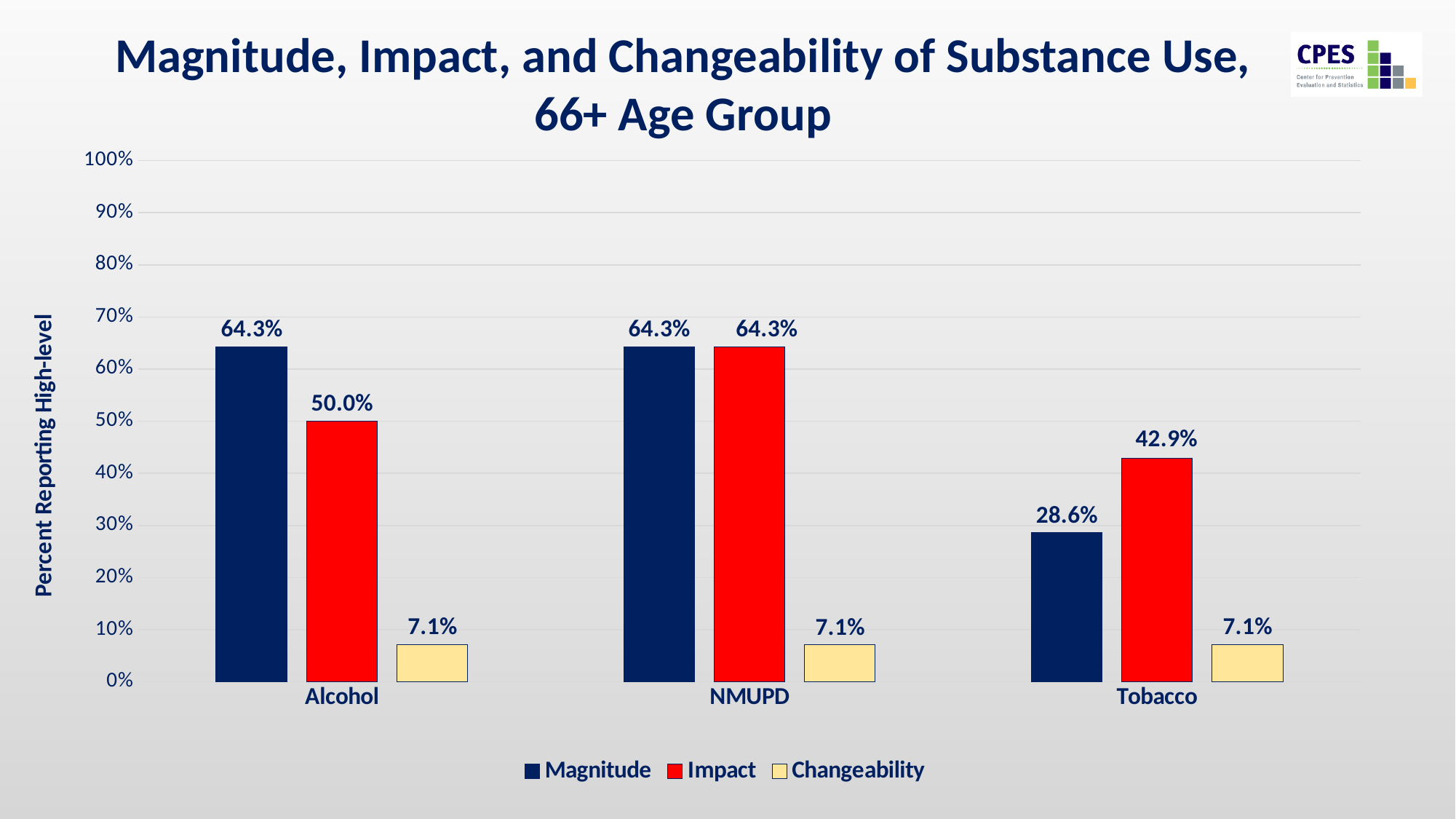
Which substance has the highest Impact value? NMUPD Which substance has the lowest Magnitude value? Tobacco What is the difference between the Magnitude and Impact values for Alcohol? 14.3% How many series does the legend list? 3 How many substance categories are shown on the x axis? 3 What is the Magnitude value for Alcohol? 64.3% Which is larger for Tobacco, the Magnitude value or the Impact value? Impact What is the Changeability value for NMUPD? 7.1% What is the Magnitude value for Tobacco? 28.6% What is the difference between the Impact values for NMUPD and Tobacco? 21.4% What type of chart is shown on the slide? Bar chart What is the Impact value for Tobacco? 42.9%